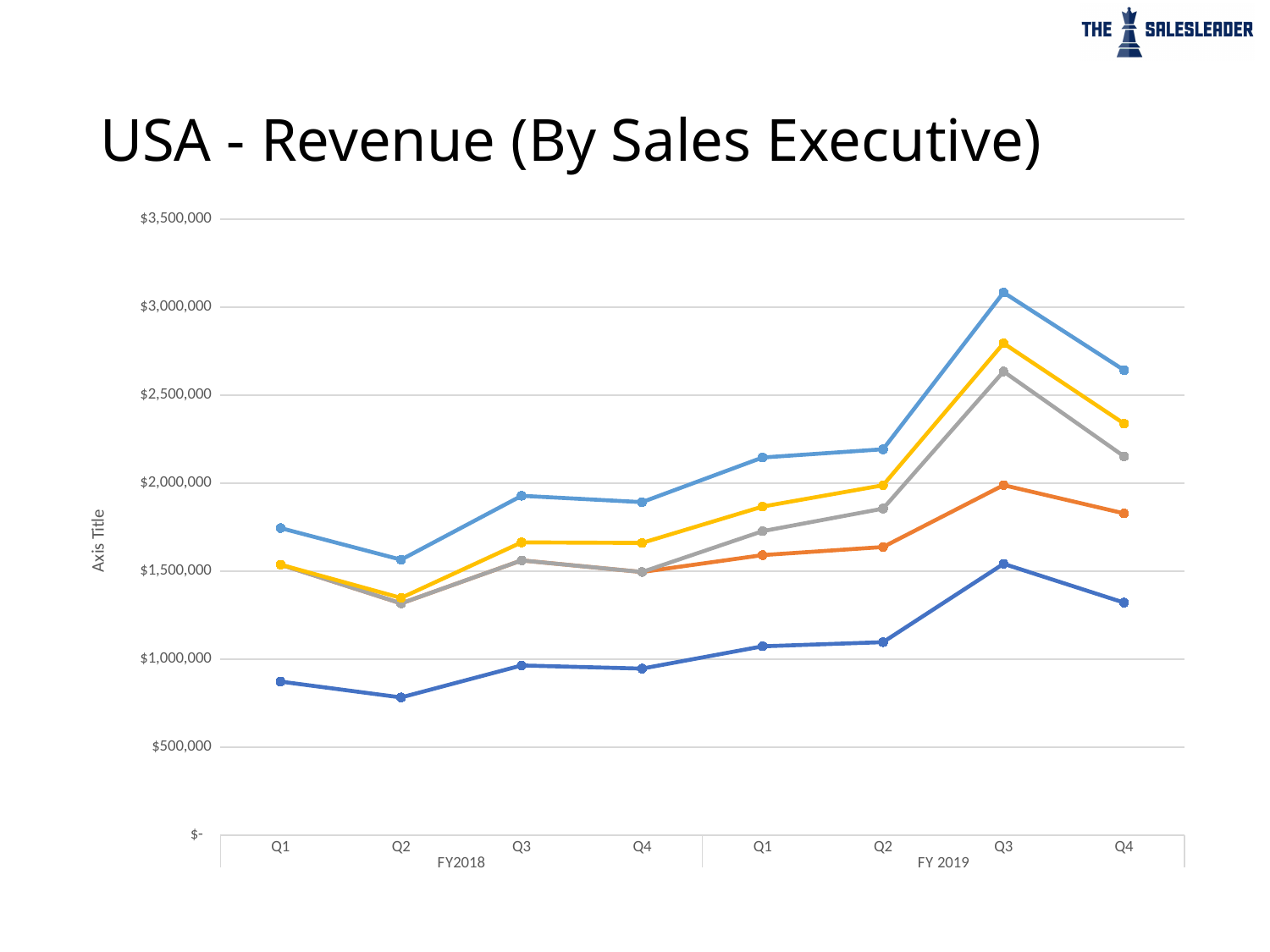
At Q3 FY 2019, which line has the larger value, the light blue line or the orange line? The light blue line How many lines are plotted on the chart? 5 How many quarters are plotted along the x axis of the chart? 8 What kind of chart is shown on the slide? Line chart Is the value of the orange line at Q4 FY 2019 greater or less than $2,000,000? less In which quarter does the dark blue line reach its lowest value? Q2 FY2018 Does the dark blue line rise or fall from Q2 FY2018 to Q3 FY 2019? Rise What label is shown on the vertical axis of the chart? Axis Title In which quarter does the light blue line reach its highest value? Q3 FY 2019 Is the value of the yellow line at Q3 FY 2019 greater or less than $2,500,000? greater Is the value of the dark blue line at Q2 FY2018 greater or less than $1,000,000? less What is the title of the chart on the slide? USA - Revenue (By Sales Executive)